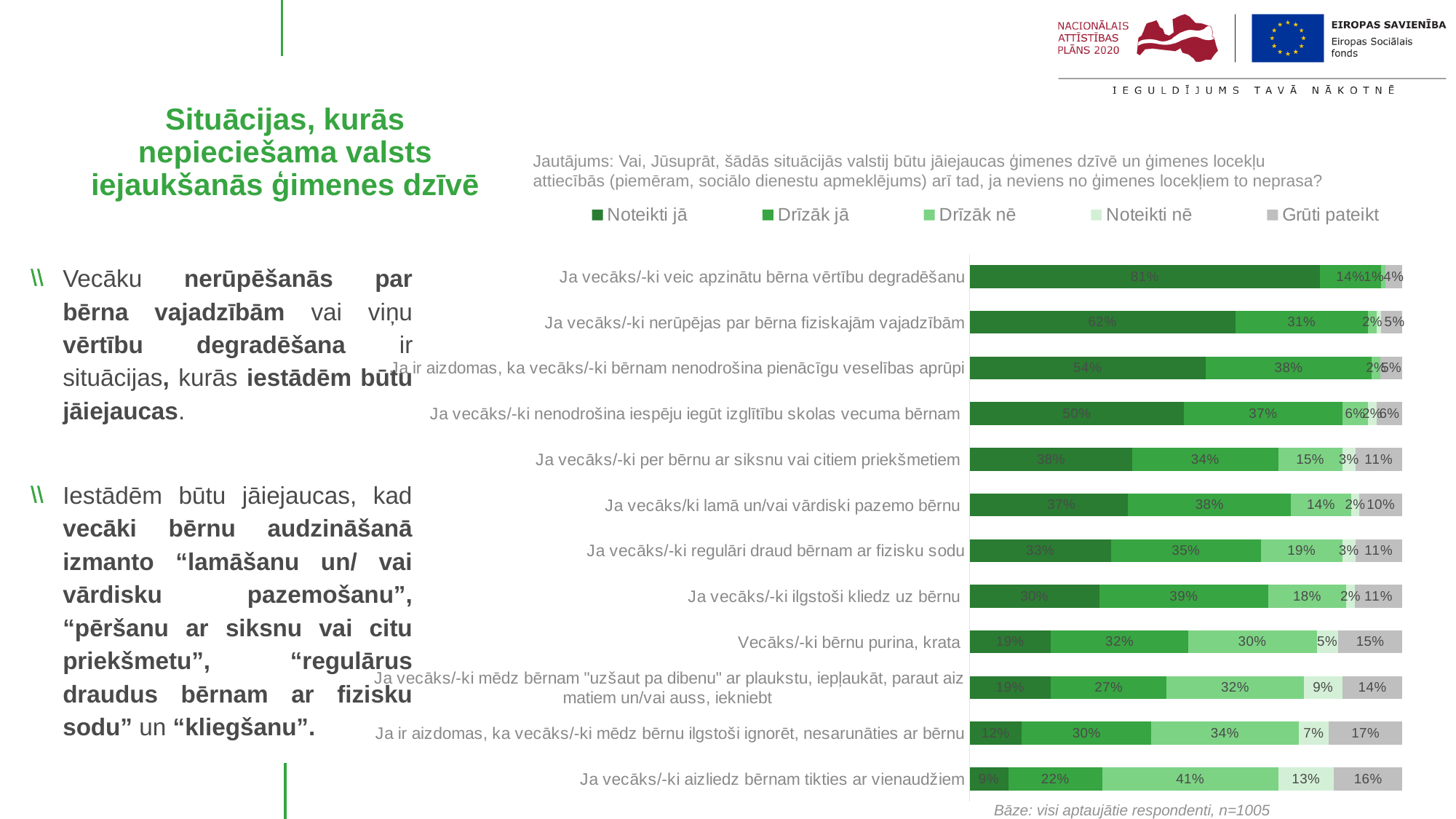
What is the first entry in the chart's legend? Noteikti jā Which situation has the lowest "Noteikti jā" value? Ja vecāks/-ki aizliedz bērnam tikties ar vienaudžiem What is the total of the stacked bar for "Ja vecāks/-ki ilgstoši kliedz uz bērnu"? 100% Which situation has the highest "Noteikti jā" value? Ja vecāks/-ki veic apzinātu bērna vērtību degradēšanu What is the difference between the "Noteikti jā" values for "Ja vecāks/-ki per bērnu ar siksnu vai citiem priekšmetiem" and "Ja vecāks/-ki ilgstoši kliedz uz bērnu"? 8 percentage points What kind of chart is shown on the slide? bar chart Which has the larger "Drīzāk nē" value: "Ja vecāks/-ki aizliedz bērnam tikties ar vienaudžiem" or "Vecāks/-ki bērnu purina, krata"? Ja vecāks/-ki aizliedz bērnam tikties ar vienaudžiem What is the "Noteikti jā" value for "Ja vecāks/-ki aizliedz bērnam tikties ar vienaudžiem"? 9% What is the "Drīzāk jā" value for "Ja vecāks/-ki ilgstoši kliedz uz bērnu"? 39% What is the "Grūti pateikt" value for "Ja ir aizdomas, ka vecāks/-ki mēdz bērnu ilgstoši ignorēt, nesarunāties ar bērnu"? 17% How many series does the legend list? 5 How many situations (categories) are plotted in the chart? 12